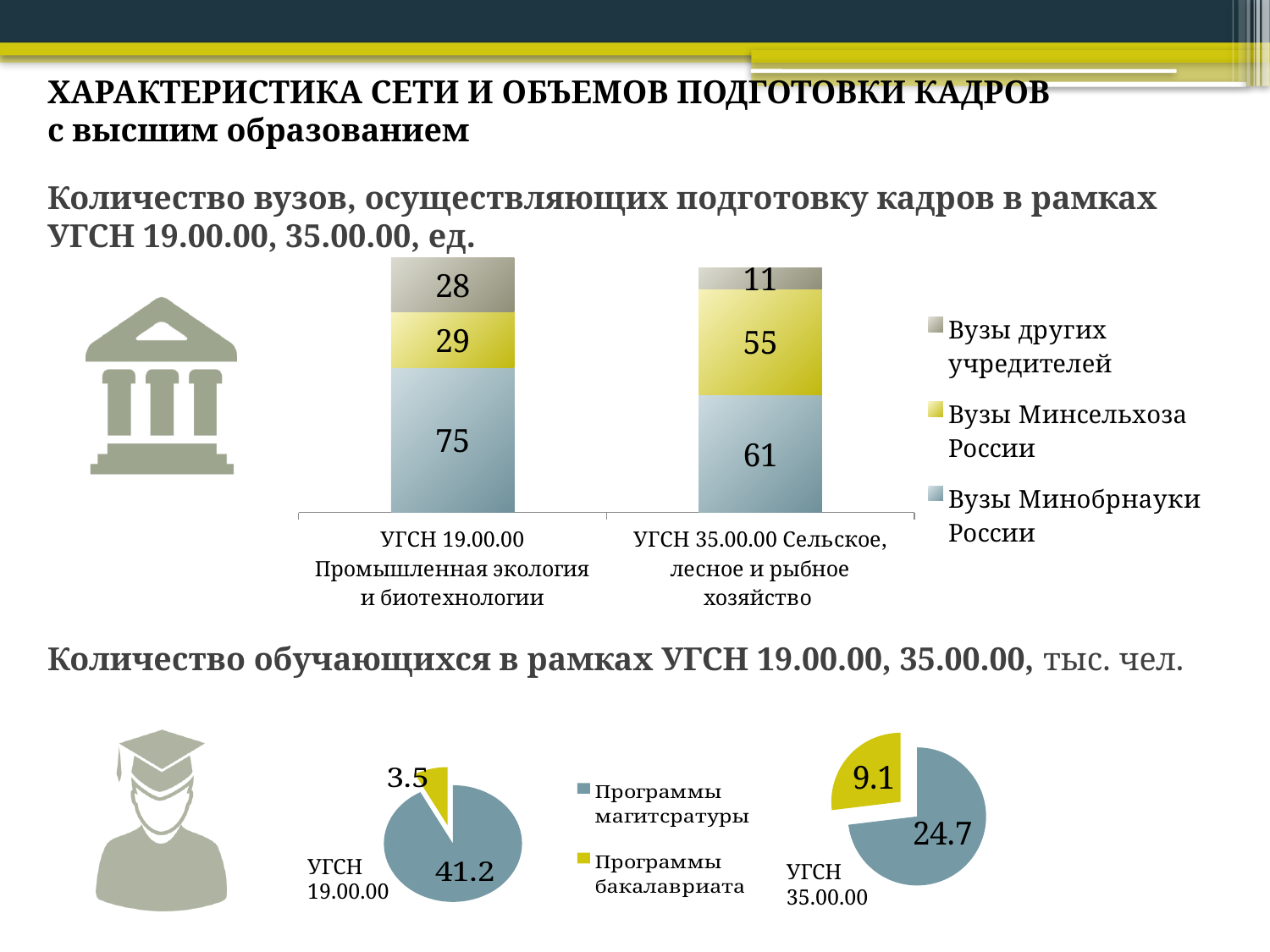
In the top chart on the number of universities, what is the difference between the Вузы Минсельхоза России values for УГСН 35.00.00 and УГСН 19.00.00? 26 In the top chart on the number of universities, how many universities of the Ministry of Education and Science (Вузы Минобрнауки России) are in УГСН 19.00.00? 75 How many series does the legend of the top chart on the number of universities list? 3 In the top chart on the number of universities, what is the value for Вузы Минсельхоза России in УГСН 35.00.00? 55 In the bottom-right pie chart for УГСН 35.00.00, what is the value for Программы магистратуры? 24.7 What kind of chart is the top chart on the number of universities? Stacked bar chart In the bottom-left pie chart for УГСН 19.00.00, what is the value for Программы бакалавриата? 3.5 In the top chart on the number of universities, what is the value for Вузы других учредителей in УГСН 35.00.00? 11 In the top chart on the number of universities, what is the total height of the stacked bar for УГСН 35.00.00? 127 In the top chart on the number of universities, what is the total height of the stacked bar for УГСН 19.00.00? 132 In the bottom-right pie chart for УГСН 35.00.00, what is the difference between the two slices? 15.6 In the top chart on the number of universities, which category has more Вузы других учредителей, УГСН 19.00.00 or УГСН 35.00.00? УГСН 19.00.00